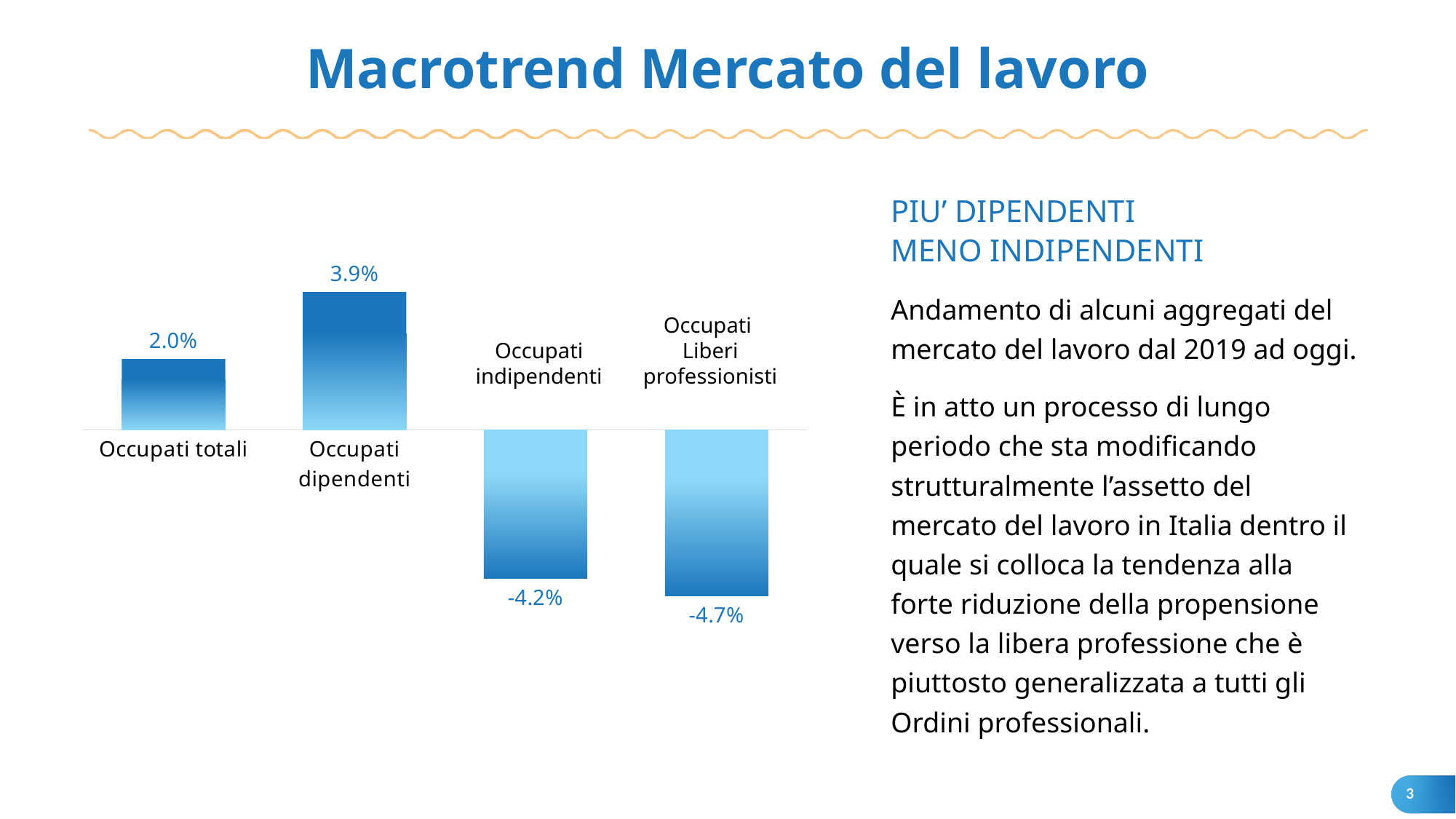
Which is larger, the value for Occupati totali or the value for Occupati dipendenti? Occupati dipendenti What is the value for Occupati dipendenti? 3.9% What kind of chart is shown on the slide? Bar chart What is the value for Occupati totali? 2.0% How many categories in the chart have negative values? 2 What is the value for Occupati indipendenti? -4.2% What is the difference between the values for Occupati dipendenti and Occupati totali? 1.9% How many categories are shown in the chart? 4 Which category has the lowest value? Occupati Liberi professionisti What is the value for Occupati Liberi professionisti? -4.7% What is the difference between the values for Occupati indipendenti and Occupati Liberi professionisti? 0.5% Which category has the highest value? Occupati dipendenti